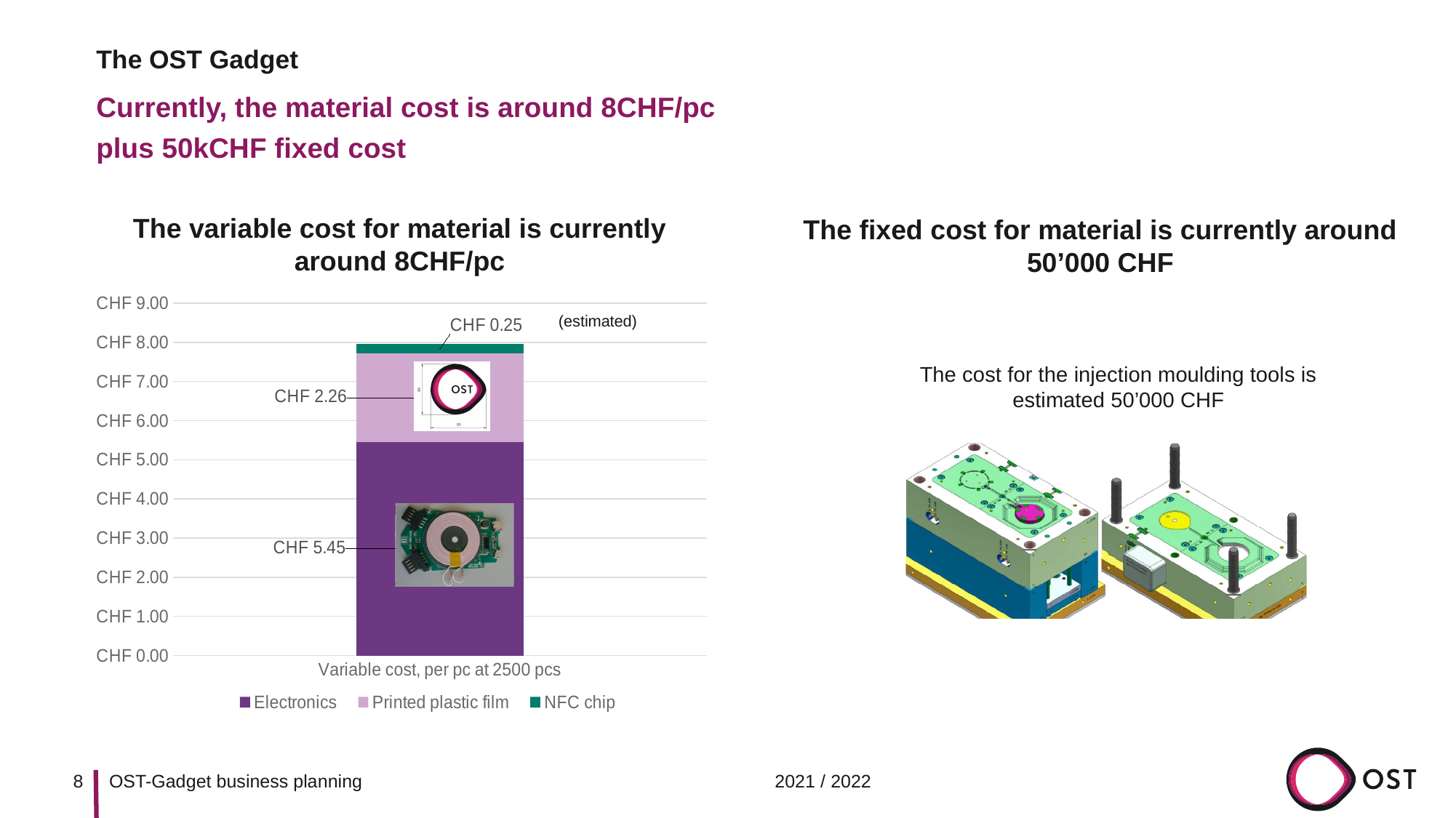
What is the total of the stacked bar (Electronics + Printed plastic film + NFC chip)? CHF 7.96 What kind of chart is shown on the slide? Stacked bar chart What is the value for Printed plastic film in the variable cost chart? CHF 2.26 How many series does the legend list? 3 Is the total height of the stacked bar greater or less than CHF 8.00? less Which is larger, the Printed plastic film value or the NFC chip value? Printed plastic film Which series has the smallest value in the stacked bar? NFC chip What is the category label on the x axis of the chart? Variable cost, per pc at 2500 pcs What is the value for NFC chip in the variable cost chart? CHF 0.25 What is the difference between the Electronics value and the Printed plastic film value? CHF 3.19 Which series has the largest value in the stacked bar? Electronics What is the value for Electronics in the variable cost chart? CHF 5.45